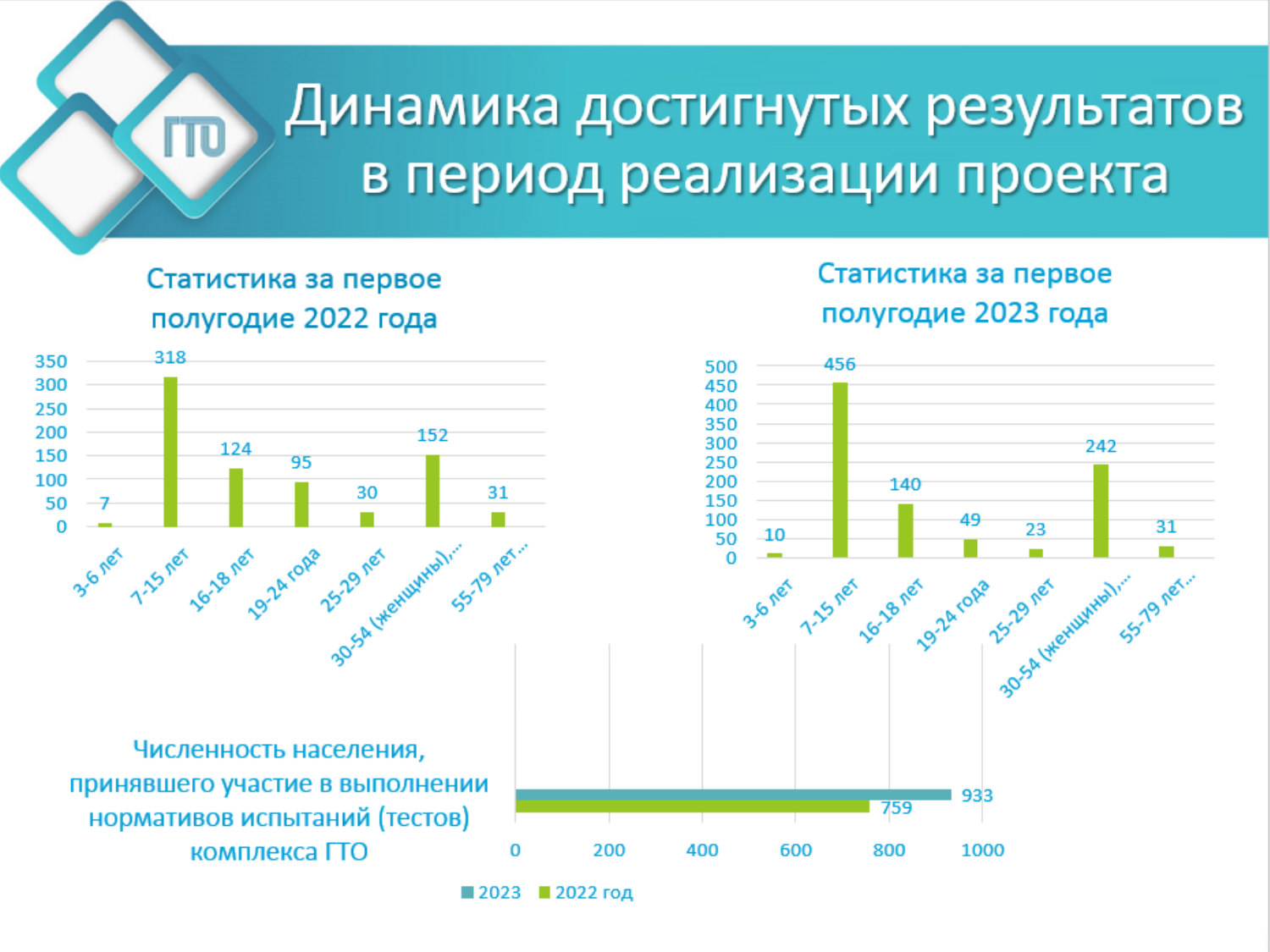
What type of chart is the bottom chart 'Численность населения, принявшего участие в выполнении нормативов испытаний (тестов) комплекса ГТО'? bar chart How many series does the legend of the bottom chart 'Численность населения...' list? 2 In the chart 'Статистика за первое полугодие 2022 года', which is larger: the value for 16-18 лет or the value for 19-24 года? 16-18 лет In the bottom chart 'Численность населения...', what is the value for 2023? 933 In the chart 'Статистика за первое полугодие 2022 года', which category has the lowest value? 3-6 лет In the chart 'Статистика за первое полугодие 2023 года', which category has the highest value? 7-15 лет In the chart 'Статистика за первое полугодие 2023 года', what is the value for 25-29 лет? 23 In the chart 'Статистика за первое полугодие 2022 года', what is the value for 7-15 лет? 318 In the chart 'Статистика за первое полугодие 2023 года', what is the value for 16-18 лет? 140 How many categories are shown in the chart 'Статистика за первое полугодие 2022 года'? 7 In the chart 'Статистика за первое полугодие 2023 года', what is the difference between the values for 7-15 лет and 30-54 (женщины)? 214 In the bottom chart 'Численность населения...', what is the difference between the 2023 value and the 2022 год value? 174